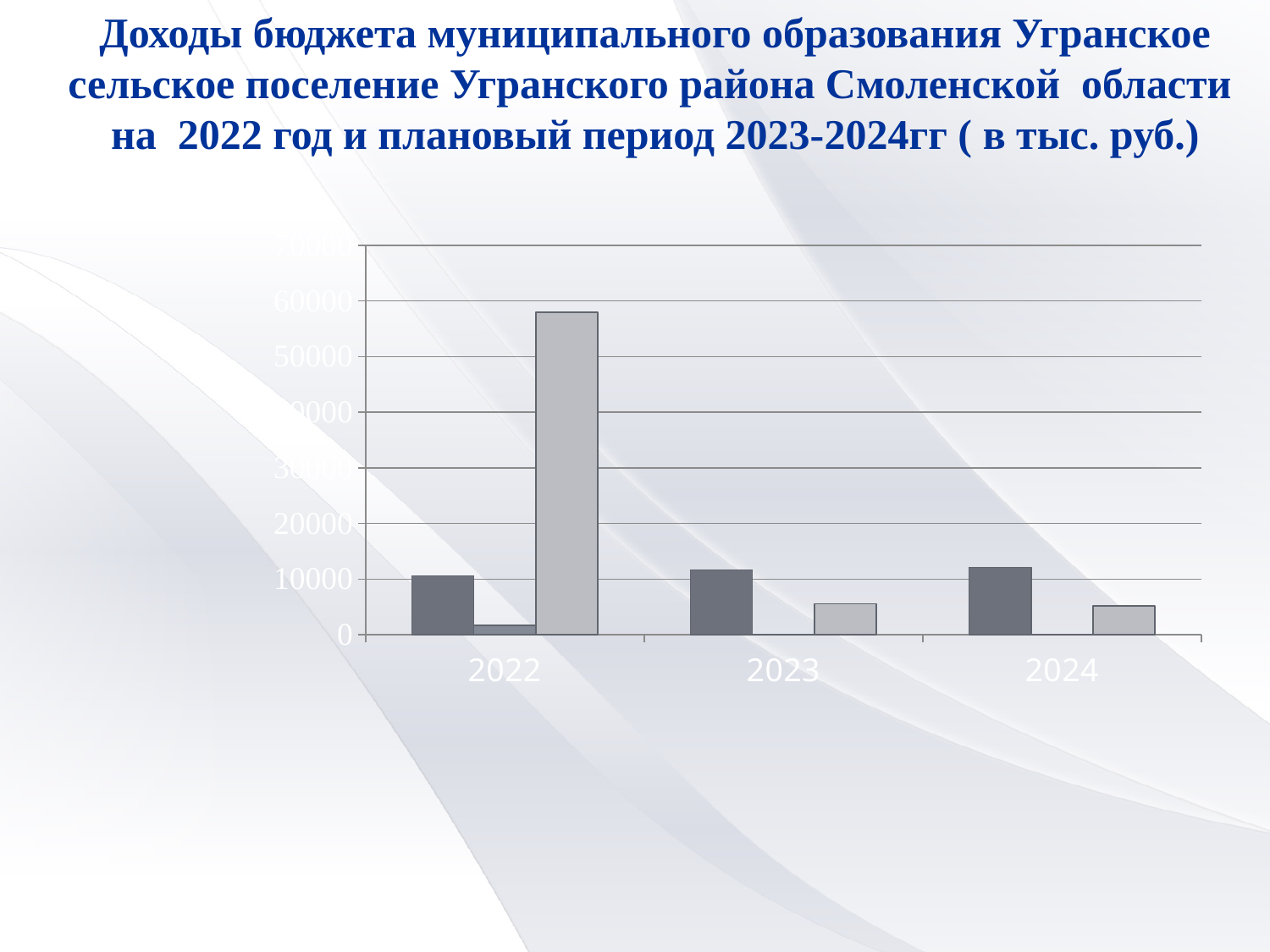
Do the dark (first) bars rise or fall from 2022 to 2024? rise Is the value of the dark (first) bar in the 2023 group greater or less than 10000? greater Is the value of the tallest bar in the 2022 group greater or less than 60000? less What kind of chart is shown on the slide? bar chart Is the value of the dark (first) bar in the 2022 group greater or less than 20000? less What is the highest value shown on the chart's vertical axis? 70000 Which is larger: the light (third) bar for 2022 or the light (third) bar for 2023? 2022 Which year category contains the tallest bar in the chart? 2022 Which is larger: the dark (first) bar for 2024 or the light (third) bar for 2024? the dark (first) bar How many year categories are shown on the x axis of the chart? 3